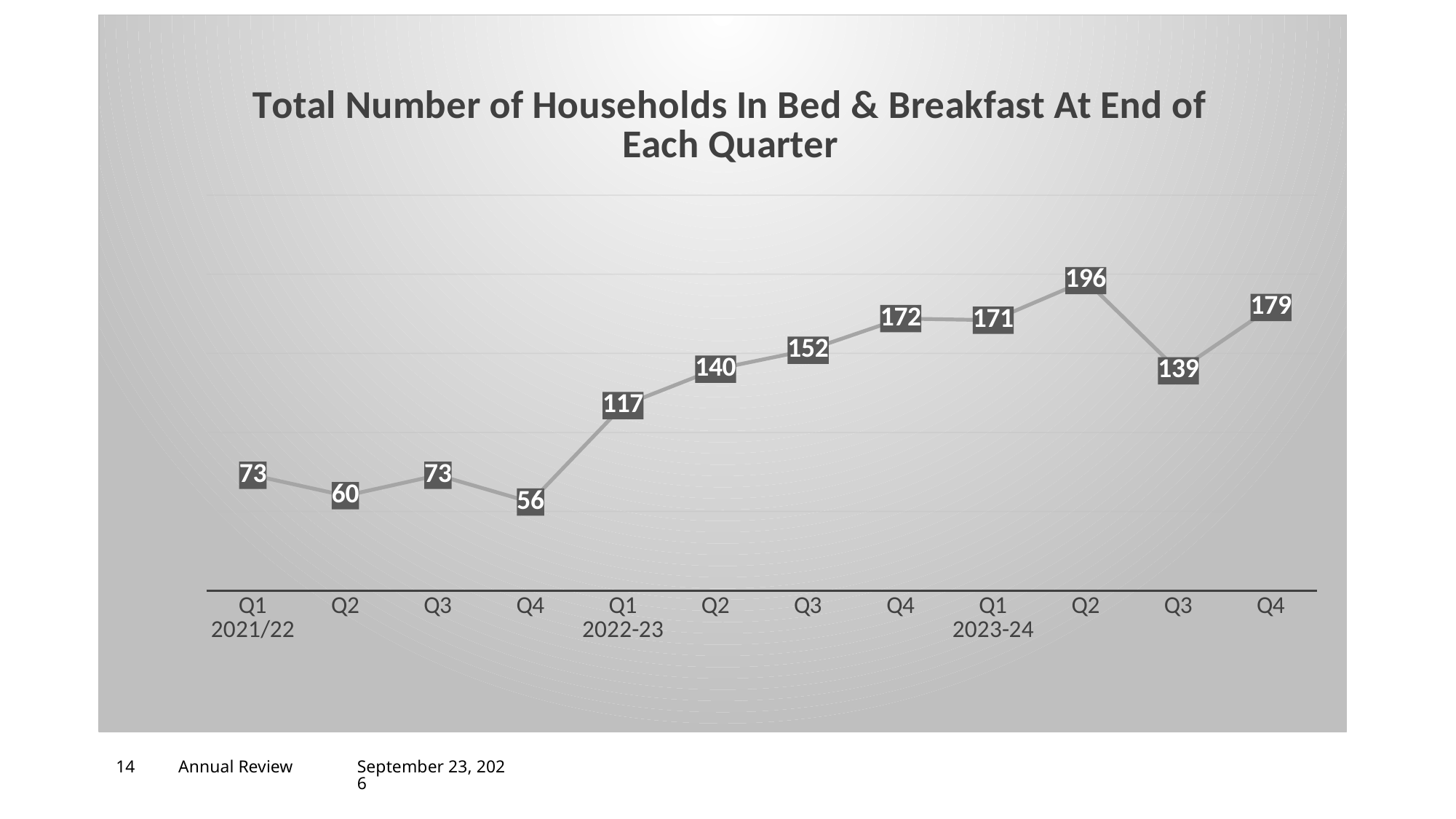
What is the difference between the values for Q1 2022-23 and Q4 2021/22? 61 What is the title of the chart? Total Number of Households In Bed & Breakfast At End of Each Quarter How many data points are plotted on the chart? 12 What is the difference between the values for Q2 2023-24 and Q3 2023-24? 57 What type of chart is shown on the slide? Line chart Which quarter has the lowest number of households? Q4 2021/22 What is the value for Q2 2023-24? 196 What is the total number of households in bed & breakfast at the end of Q1 2021/22? 73 Does the number of households rise or fall from Q4 2021/22 to Q2 2023-24? Rise What is the value for Q3 2023-24? 139 Which quarter has the highest number of households? Q2 2023-24 Which is larger, the value for Q4 2022-23 or the value for Q1 2023-24? Q4 2022-23